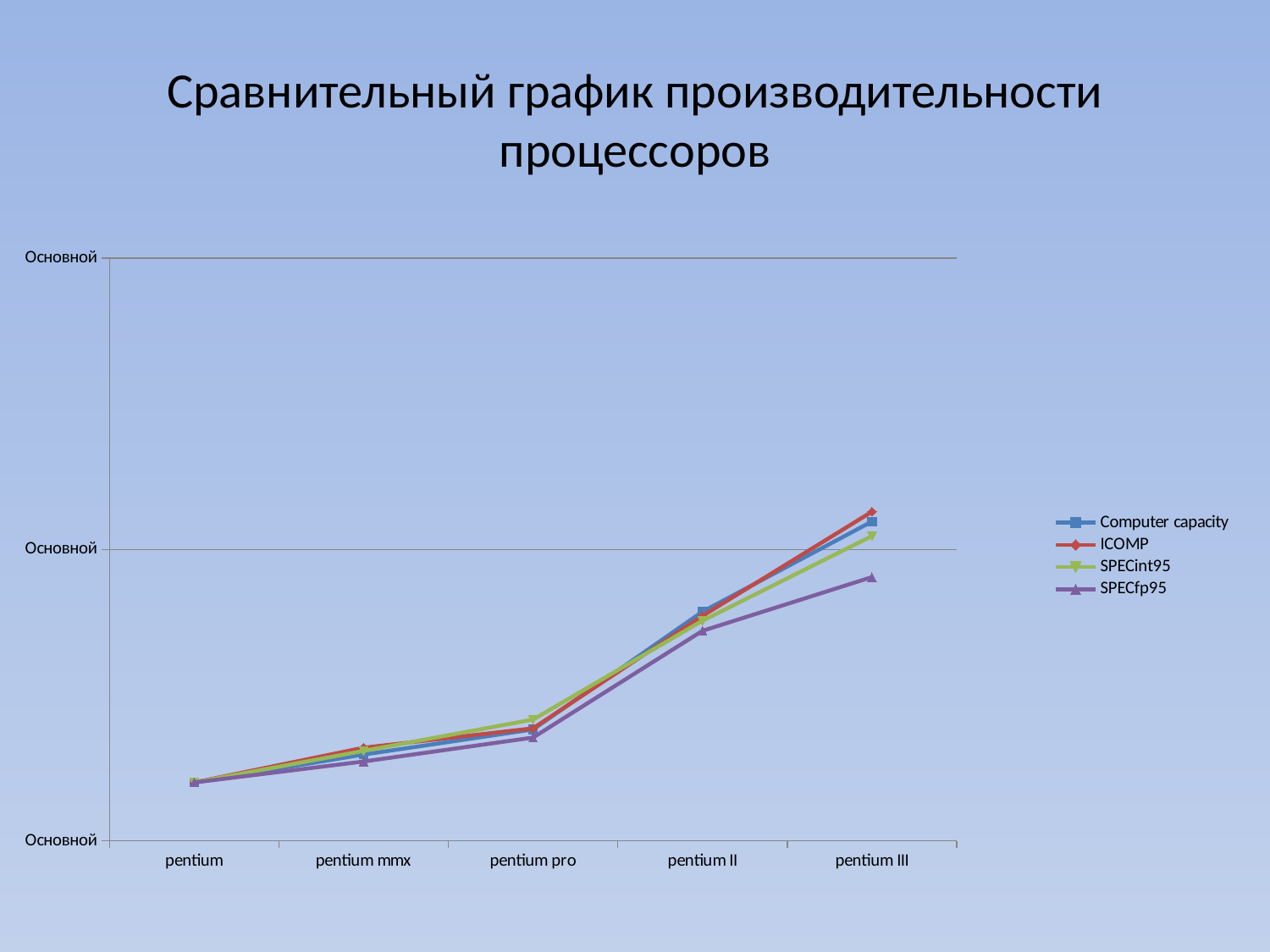
Which is larger at pentium III: the value for SPECint95 or the value for SPECfp95? SPECint95 Which series is drawn in red in the legend? ICOMP Which series has the lowest value at pentium III? SPECfp95 Which is larger for the SPECfp95 series: the value at pentium pro or the value at pentium II? pentium II Do the values of the ICOMP series rise or fall from pentium to pentium III? rise What is the title of the chart on the slide? Сравнительный график производительности процессоров Which series has the lowest value at pentium II? SPECfp95 Which series has the lowest value at pentium mmx? SPECfp95 How many series does the legend list? 4 Which series has the highest value at pentium III? ICOMP How many processor categories are shown on the x axis? 5 What kind of chart is shown on the slide? line chart